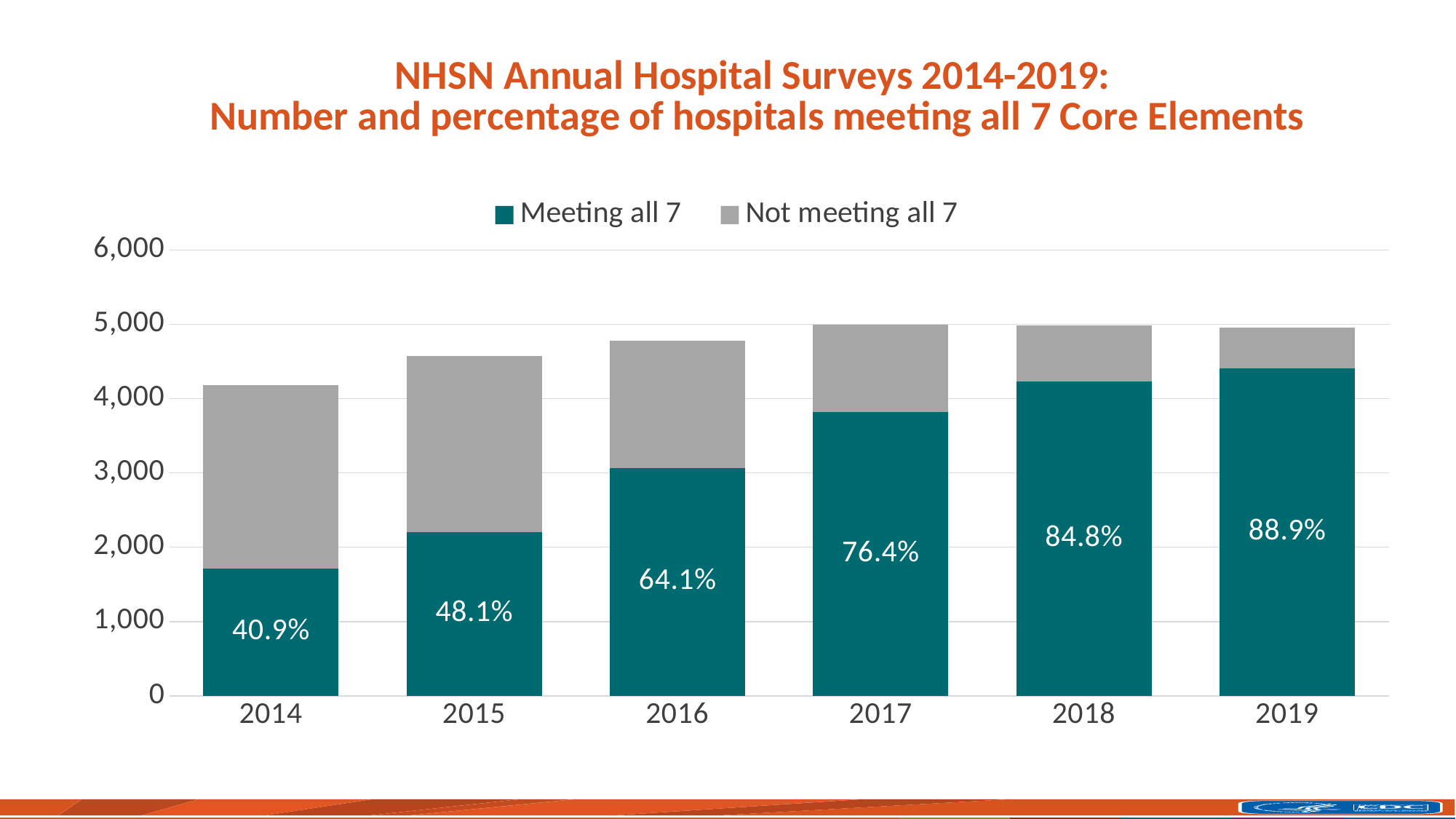
Which year has the lowest percentage of hospitals meeting all 7 Core Elements? 2014 Which year has a higher percentage of hospitals meeting all 7 Core Elements, 2016 or 2018? 2018 Is the total height of the 2014 stacked bar greater or less than 4,000? greater What percentage label is shown on the 2019 bar? 88.9% Is the number of hospitals meeting all 7 Core Elements in 2014 greater or less than 2,000? less What percentage of hospitals met all 7 Core Elements in 2017? 76.4% How many years are shown on the x axis? 6 What percentage label is shown on the 2014 bar? 40.9% By how many percentage points did the share of hospitals meeting all 7 Core Elements increase from 2014 to 2019? 48.0 percentage points Does the percentage of hospitals meeting all 7 Core Elements rise or fall from 2014 to 2019? rise How many series does the legend list? 2 Which year has the highest percentage of hospitals meeting all 7 Core Elements? 2019